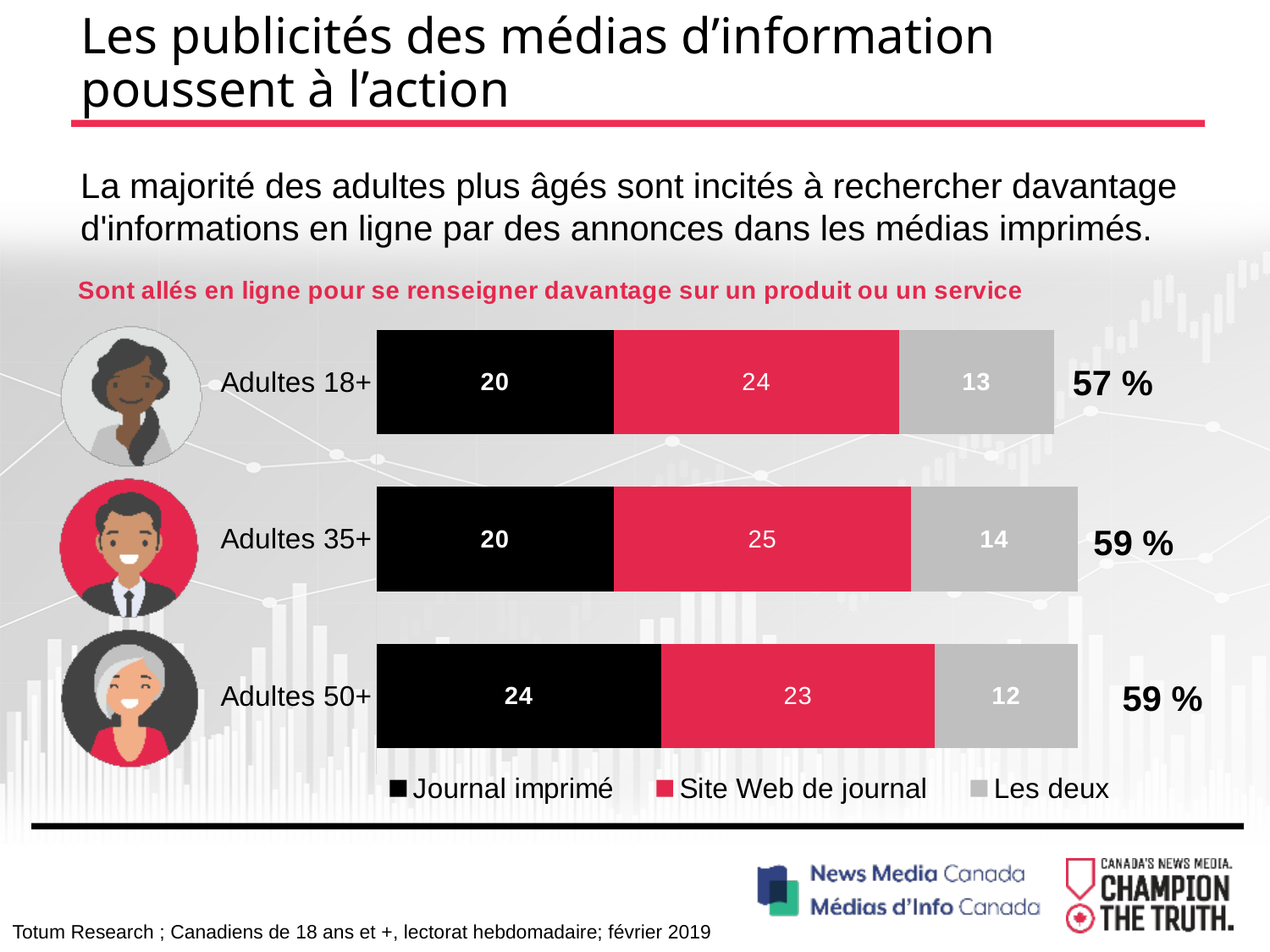
What is the total shown for the Adultes 50+ bar? 59 % What is the difference between the Site Web de journal values for Adultes 35+ and Adultes 50+? 2 What is the value for Les deux for Adultes 18+? 13 Which age group has the highest value for Journal imprimé? Adultes 50+ How many age groups are shown in the chart? 3 Which is larger for Adultes 18+: Journal imprimé or Site Web de journal? Site Web de journal What kind of chart is shown on the slide? Stacked bar chart What is the value for Site Web de journal for Adultes 35+? 25 Which age group has the lowest value for Les deux? Adultes 50+ What is the total shown for the Adultes 18+ bar? 57 % How many series does the legend list? 3 What is the value for Journal imprimé for Adultes 50+? 24